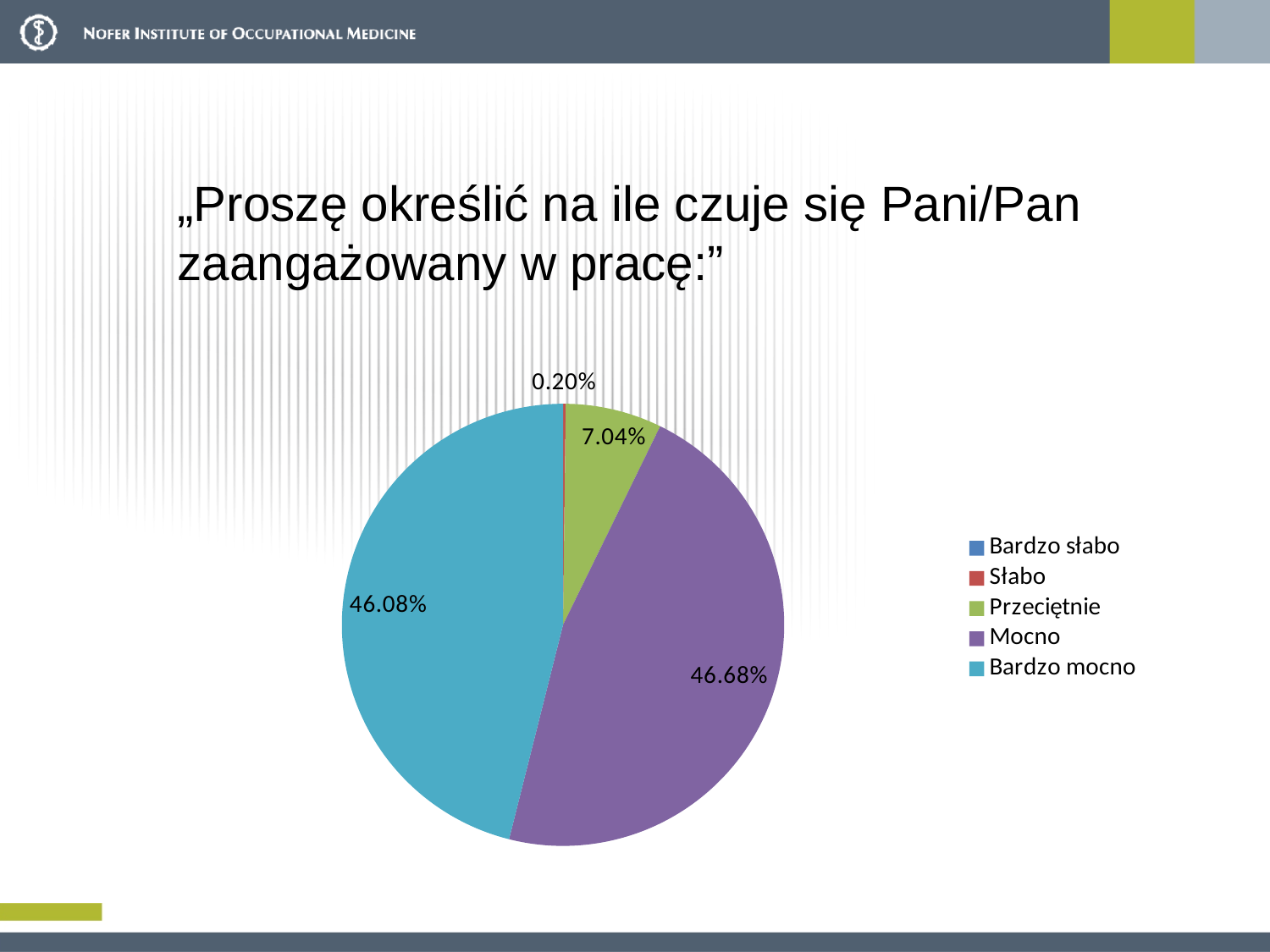
What type of chart is shown on the slide? pie chart What percentage of respondents answered "Słabo"? 0.20% What percentage of respondents answered "Bardzo mocno"? 46.08% Which is larger, the share for "Mocno" or the share for "Bardzo mocno"? Mocno Which labelled response category has the smallest share of the pie? Słabo Which response category has the largest share of the pie? Mocno What percentage of respondents answered "Mocno"? 46.68% How many response categories does the legend list? 5 What colour is the "Bardzo mocno" slice? teal (blue-green) What is the difference between the shares for "Mocno" and "Bardzo mocno"? 0.60% What is the difference between the shares for "Przeciętnie" and "Słabo"? 6.84% What percentage of respondents answered "Przeciętnie"? 7.04%